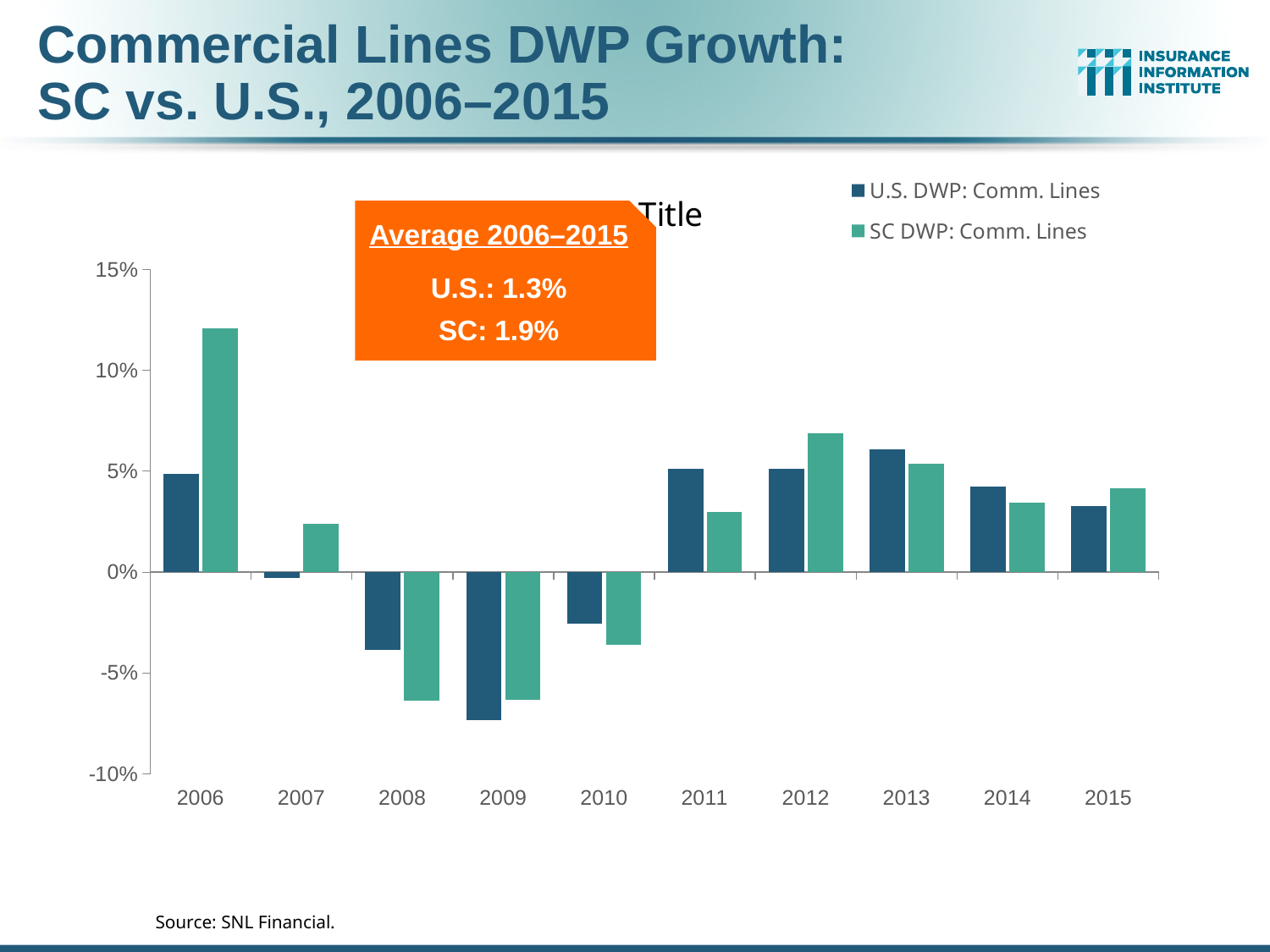
How many series does the legend list? 2 What type of chart is shown on the slide? Bar chart According to the text box on the chart, what is the average 2006–2015 growth for SC? 1.9% Is the value for U.S. DWP: Comm. Lines in 2009 greater or less than -5%? less In which year is U.S. DWP: Comm. Lines growth the lowest? 2009 In 2008, which series has the higher value, U.S. DWP: Comm. Lines or SC DWP: Comm. Lines? U.S. DWP: Comm. Lines How many years are shown on the x axis? 10 In 2006, which series has the higher value, U.S. DWP: Comm. Lines or SC DWP: Comm. Lines? SC DWP: Comm. Lines In which year is SC DWP: Comm. Lines growth the highest? 2006 Is the value for SC DWP: Comm. Lines in 2006 greater or less than 10%? greater In which year is U.S. DWP: Comm. Lines growth the highest? 2013 Is the value for U.S. DWP: Comm. Lines in 2013 greater or less than 5%? greater